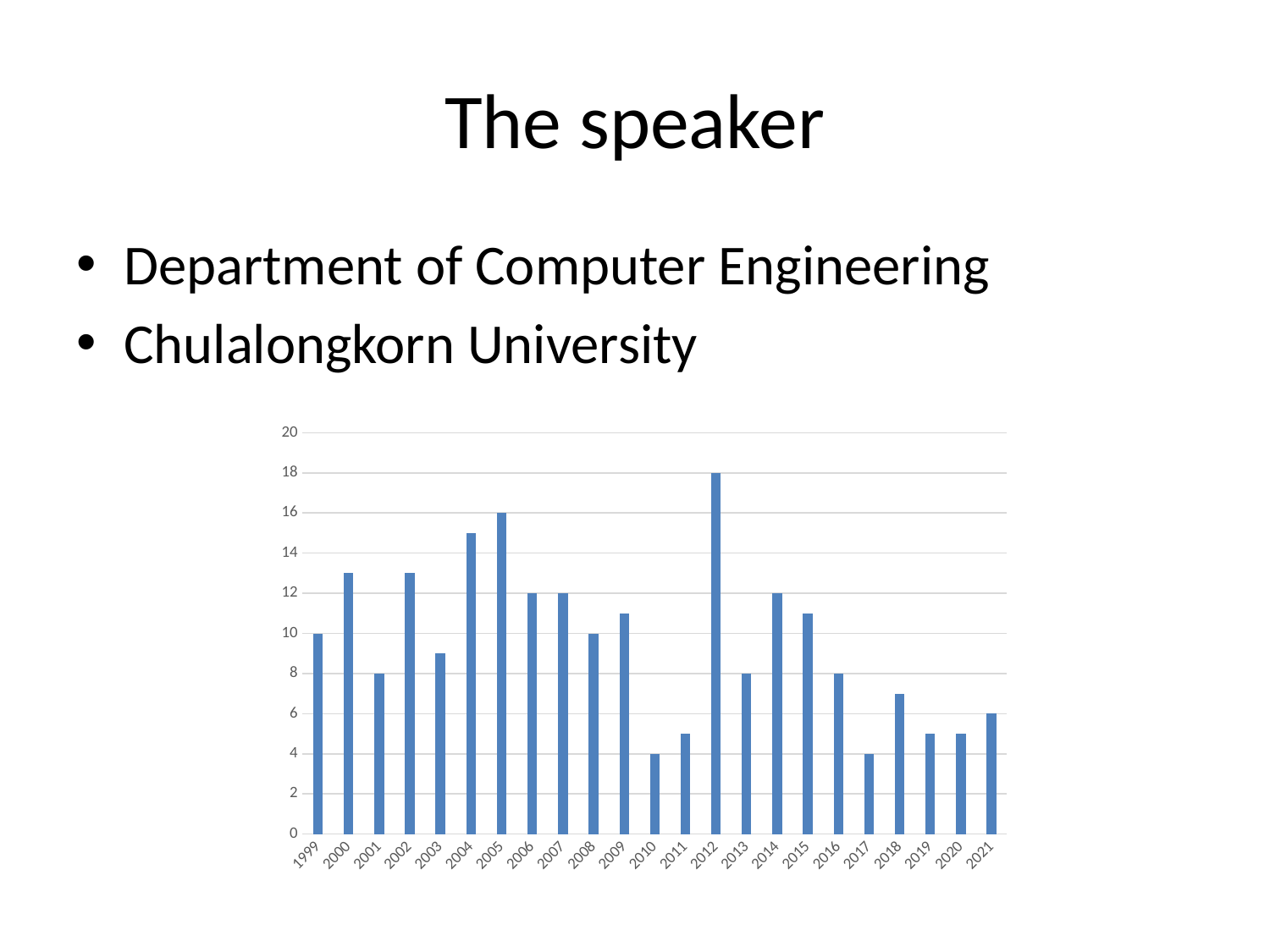
Is the value for 2004 greater or less than 14? greater Which is larger, the value for 2000 or the value for 2001? 2000 What kind of chart is shown on the slide? bar chart Do the values generally rise or fall from 2014 to 2017? fall What is the value for 2021? 6 What is the value for 2012? 18 Is the value for 2018 greater or less than 8? less How many years (bars) are shown on the chart? 23 Which year has the highest bar on the chart? 2012 What is the value for 2005? 16 What is the value for 1999? 10 What is the difference between the values for 2012 and 2010? 14